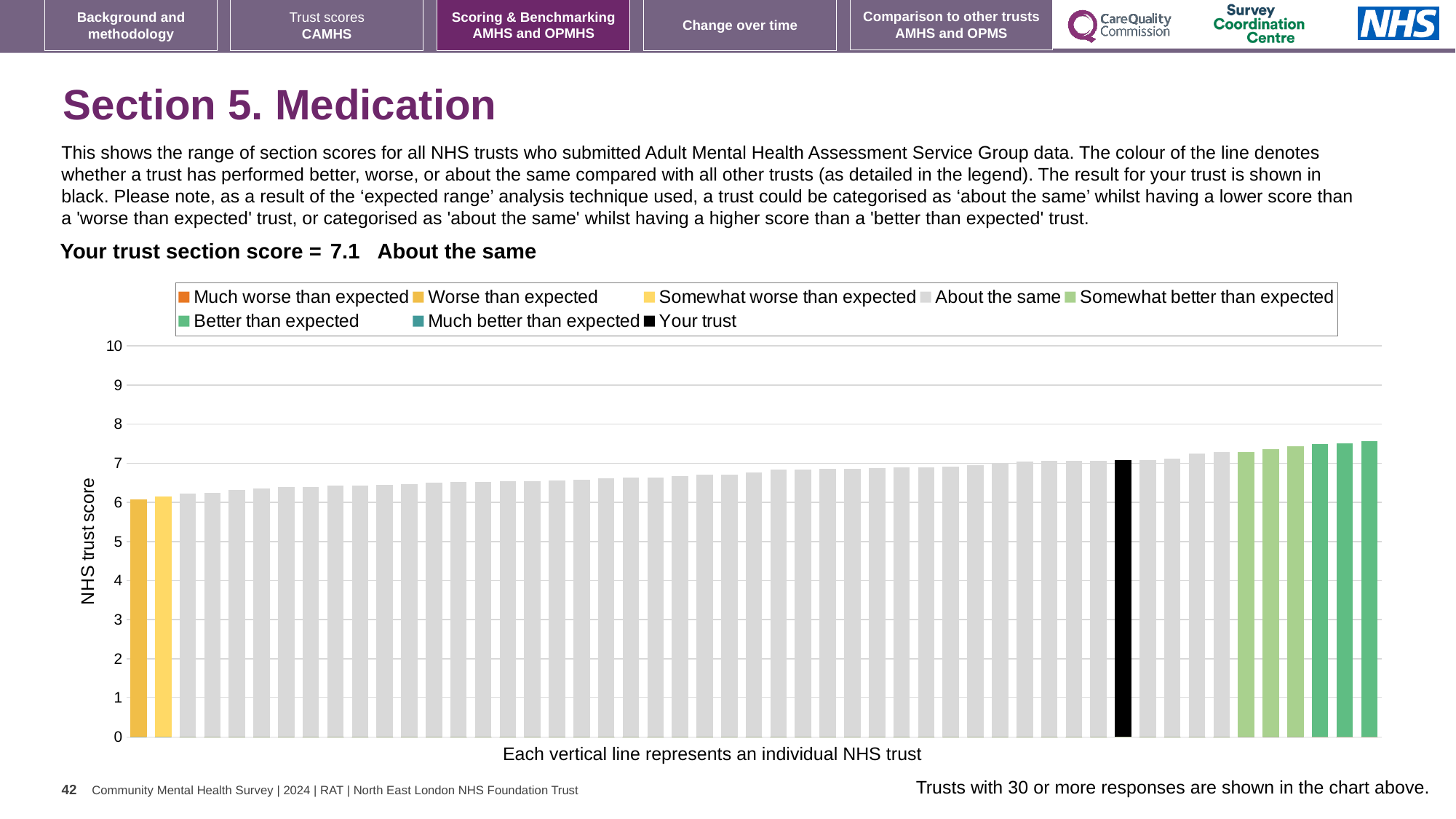
Is the value of the rightmost bar greater or less than 7? greater What is the label on the vertical axis of the chart? NHS trust score Is the value of the black 'Your trust' bar greater or less than 6? greater How is your trust's section score categorised compared with other trusts? About the same How many entries does the chart legend list? 8 Do the bar values rise or fall from left to right along the x axis? rise How many bars on the chart are shown in black? 1 Is the value of the rightmost bar greater or less than 8? less What is the section score for your trust shown on the slide? 7.1 What kind of chart is shown on the slide? bar chart What colour is the bar representing your trust? black